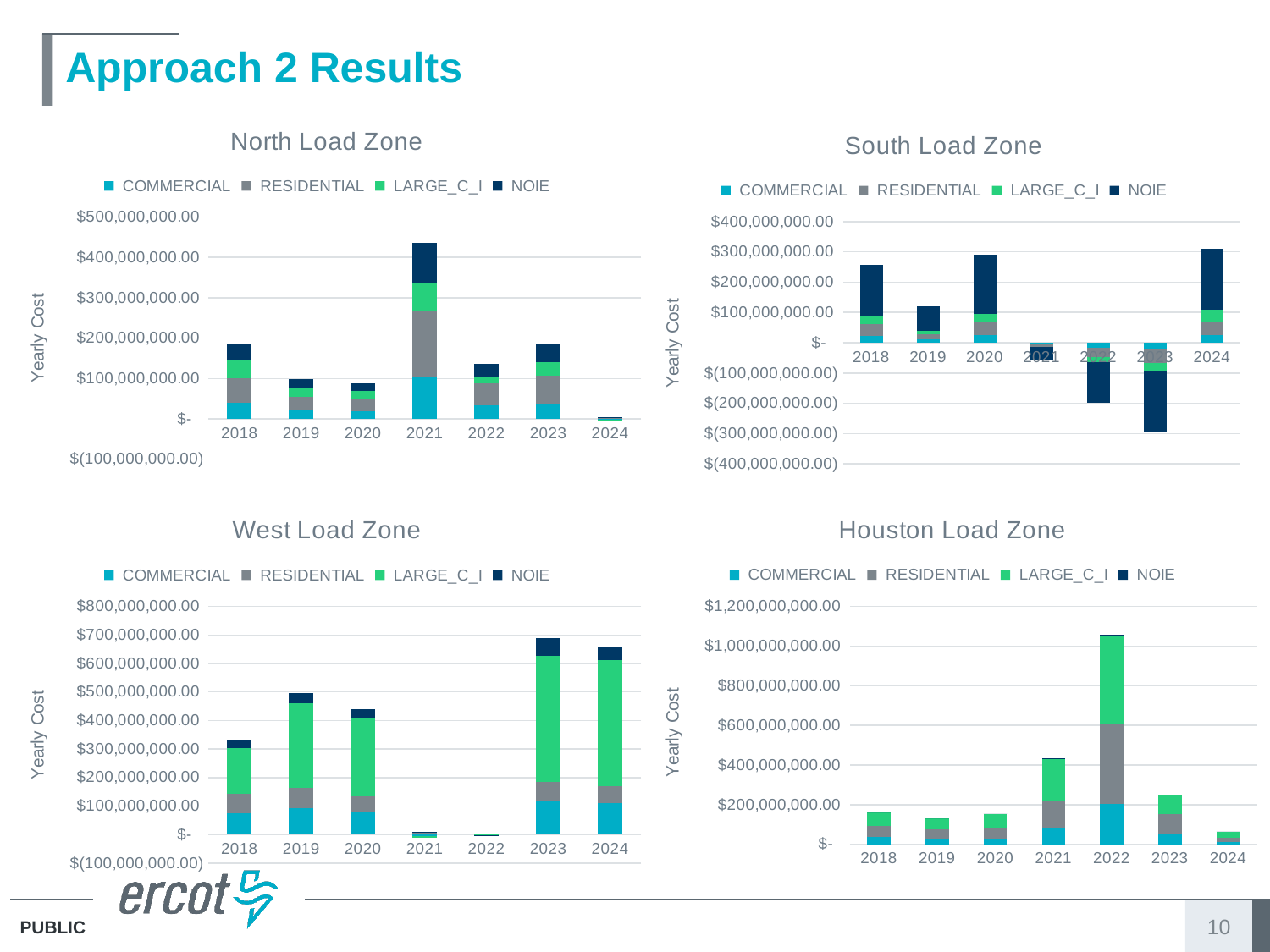
In the North Load Zone chart, is the total for 2021 greater or less than $400,000,000.00? greater In the South Load Zone chart, is the total for 2018 greater or less than $200,000,000.00? greater In the Houston Load Zone chart, do the totals rise or fall from 2022 to 2024? fall In the North Load Zone chart, which year has the tallest stacked bar? 2021 How many series does the legend of the Houston Load Zone chart list? 4 In the Houston Load Zone chart, which year has the tallest stacked bar? 2022 What kind of chart is the North Load Zone chart? stacked bar chart In the West Load Zone chart, is the total for 2023 greater or less than $600,000,000.00? greater In the South Load Zone chart, which year has the largest negative NOIE value? 2023 In the West Load Zone chart, which stacked bar is taller, 2019 or 2020? 2019 In the North Load Zone chart, which year has the smallest stacked bar? 2024 How many years are shown on the x axis of the West Load Zone chart? 7